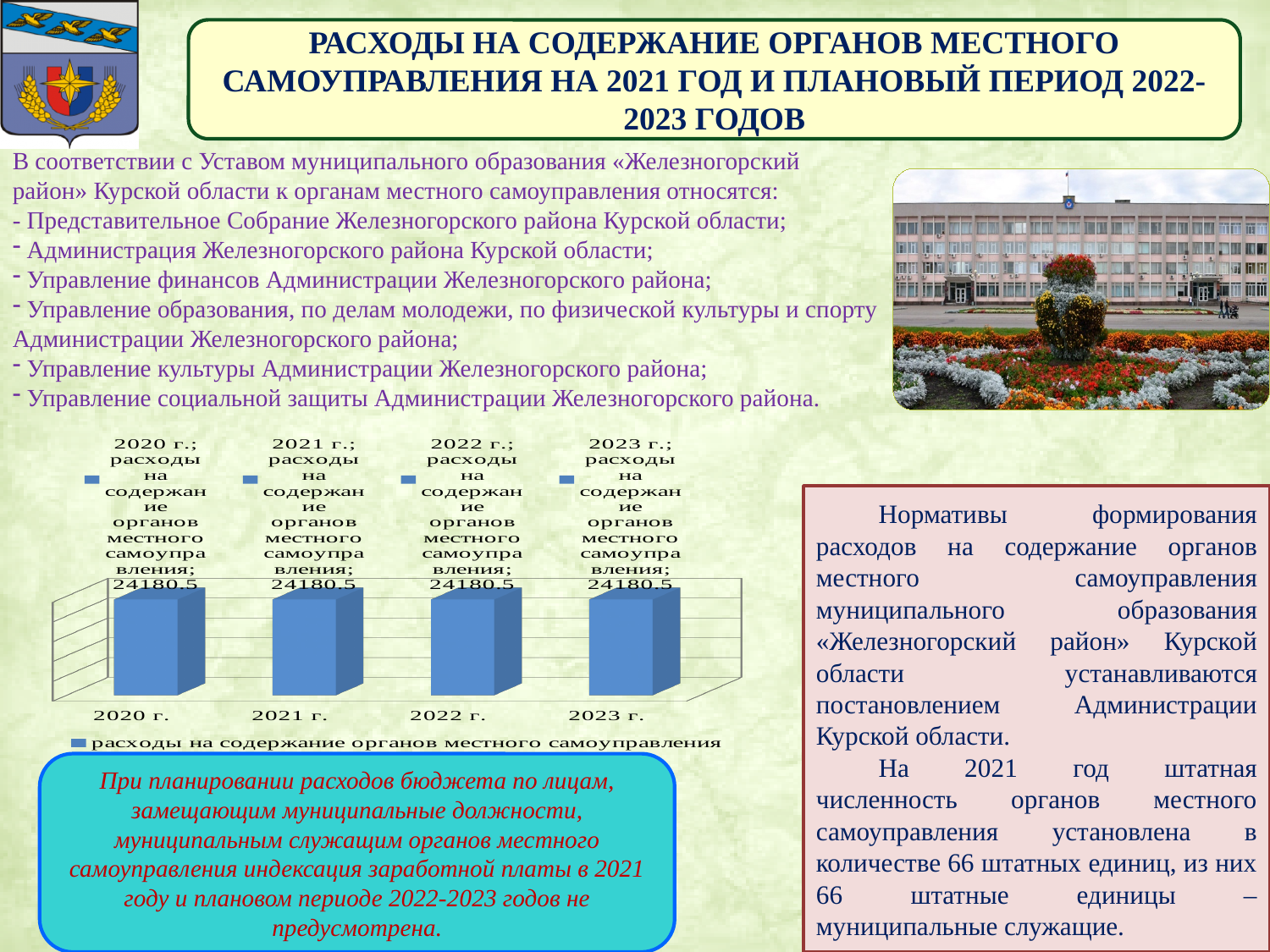
What is the value for 2022 г. in the chart? 24180.5 How many series does the chart legend list? 1 What is the value for 2023 г. in the chart? 24180.5 What is the name of the series shown in the chart legend? расходы на содержание органов местного самоуправления What is the value for 2021 г. in the chart? 24180.5 Do the values rise, fall or stay the same from 2020 г. to 2023 г.? stay the same What colour are the bars in the chart? blue What kind of chart is shown on the slide? bar chart What is the value for 2020 г. in the chart? 24180.5 How many categories (years) are shown on the x axis of the chart? 4 What is the difference between the values for 2023 г. and 2020 г.? 0